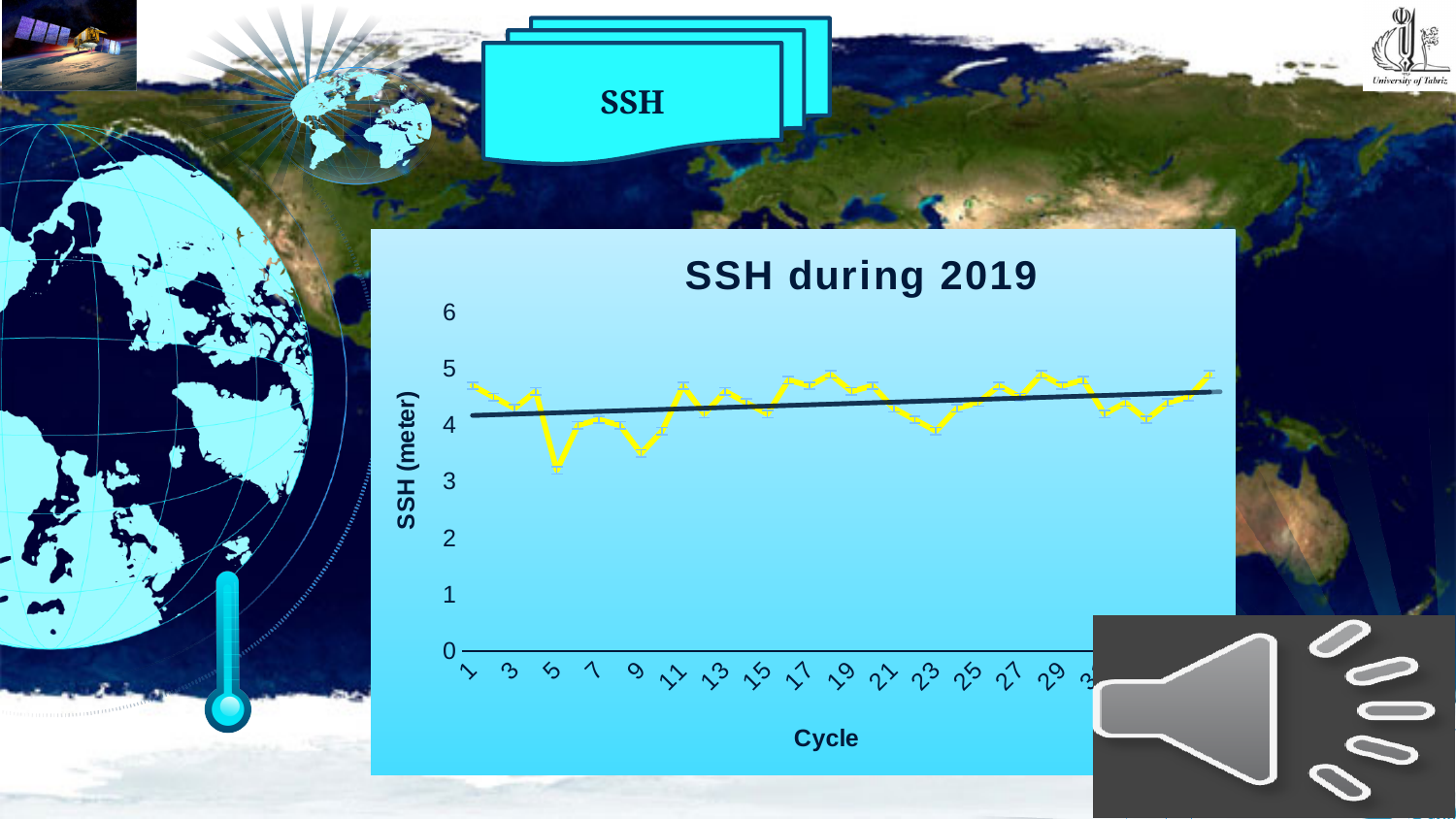
Is the SSH value at cycle 5 greater or less than 4? less What is the label of the vertical axis of the chart? SSH (meter) What kind of chart is shown on the slide? line chart Does the straight trend line drawn through the data rise or fall from left to right? rise At which cycle does the SSH line reach its lowest value? 5 What is the title of the chart? SSH during 2019 What is the highest value shown on the vertical axis of the chart? 6 Is the SSH value at cycle 1 greater or less than 4? greater Is the SSH value at cycle 9 greater or less than 4? less Which has the larger SSH value, cycle 5 or cycle 17? cycle 17